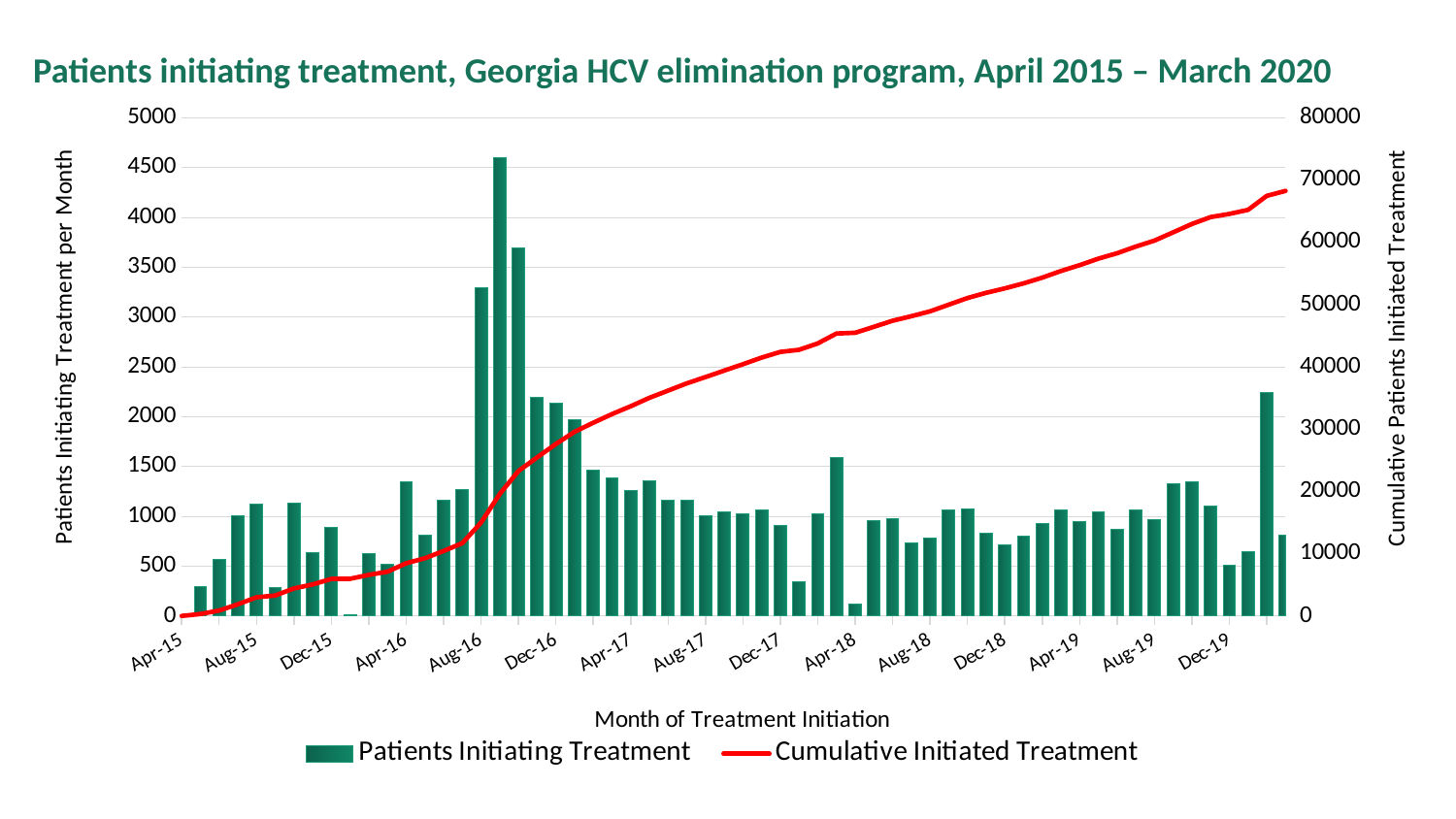
Is the tallest Patients Initiating Treatment bar greater or less than 4000? greater What is the title of the chart? Patients initiating treatment, Georgia HCV elimination program, April 2015 – March 2020 Is the Cumulative Initiated Treatment value at Dec-19 greater or less than 60000? greater Is the Patients Initiating Treatment bar for Aug-18 greater or less than 1000? less How many series does the legend list? 2 Which series is drawn as a red line? Cumulative Initiated Treatment What kind of chart is shown on the slide? A combined bar and line chart Does the Cumulative Initiated Treatment line rise or fall from Apr-15 to the end of the chart? Rises